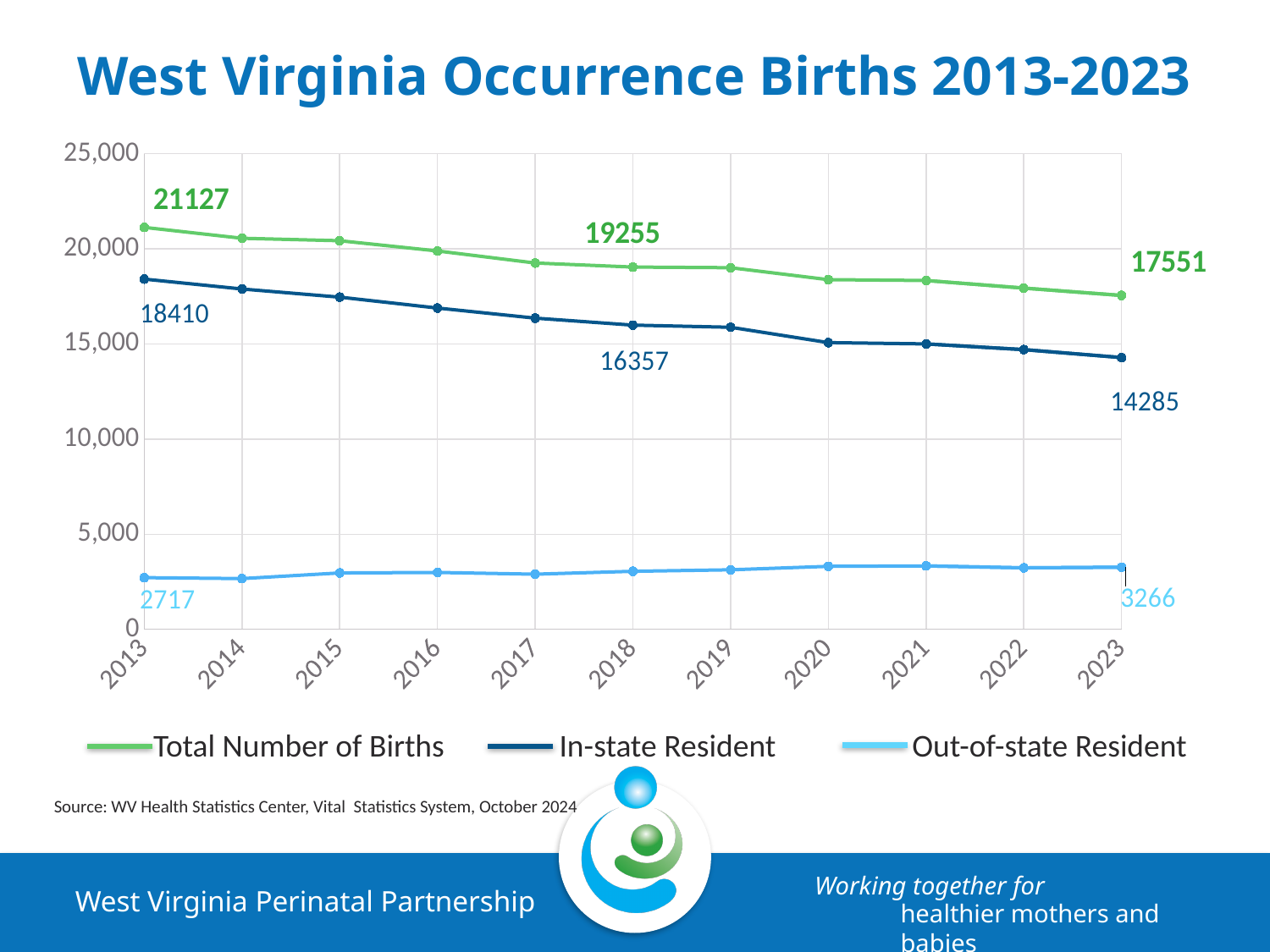
By how much did the Total Number of Births decrease from 2013 to 2023? 3576 Does the Total Number of Births rise or fall from 2013 to 2023? Fall What was the Total Number of Births in 2013? 21127 What type of chart is shown on the slide? Line chart What was the In-state Resident value in 2023? 14285 What was the Out-of-state Resident value in 2023? 3266 How many years are plotted along the x axis? 11 How many series does the legend list? 3 What is the title of the chart? West Virginia Occurrence Births 2013-2023